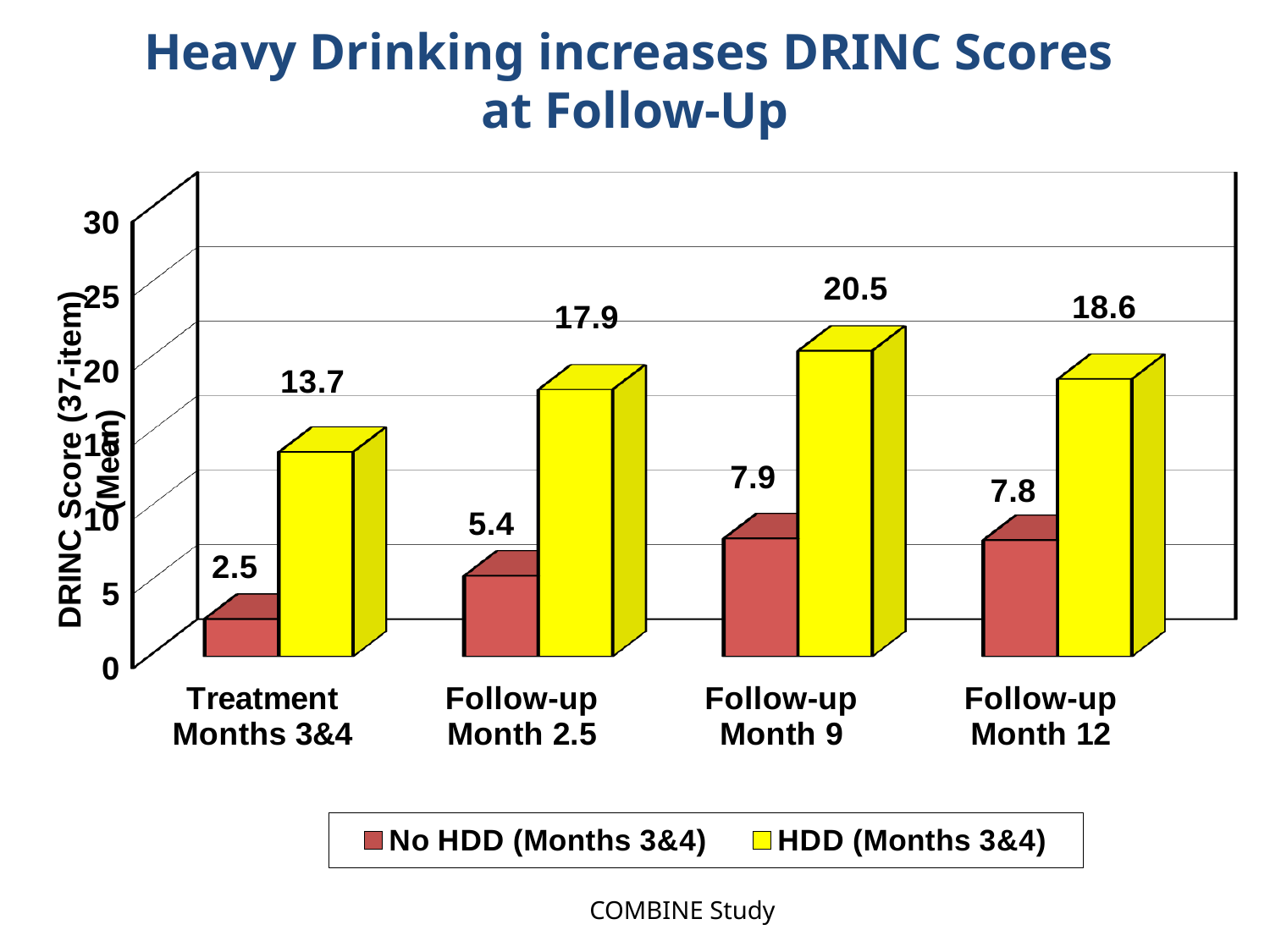
What is the DRINC score for the HDD (Months 3&4) group at Follow-up Month 9? 20.5 Is the HDD (Months 3&4) DRINC score at Treatment Months 3&4 greater or less than 10? greater How many time points are shown on the x axis? 4 Which group has the higher DRINC score at Follow-up Month 12, No HDD (Months 3&4) or HDD (Months 3&4)? HDD (Months 3&4) At which time point is the No HDD (Months 3&4) DRINC score lowest? Treatment Months 3&4 What is the label of the y axis? DRINC Score (37-item) (Mean) At which time point is the HDD (Months 3&4) DRINC score highest? Follow-up Month 9 What is the DRINC score for the HDD (Months 3&4) group at Follow-up Month 12? 18.6 What kind of chart is shown on the slide? Bar chart What is the DRINC score for the No HDD (Months 3&4) group at Treatment Months 3&4? 2.5 How many series does the legend list? 2 What is the difference between the HDD and No HDD DRINC scores at Follow-up Month 2.5? 12.5